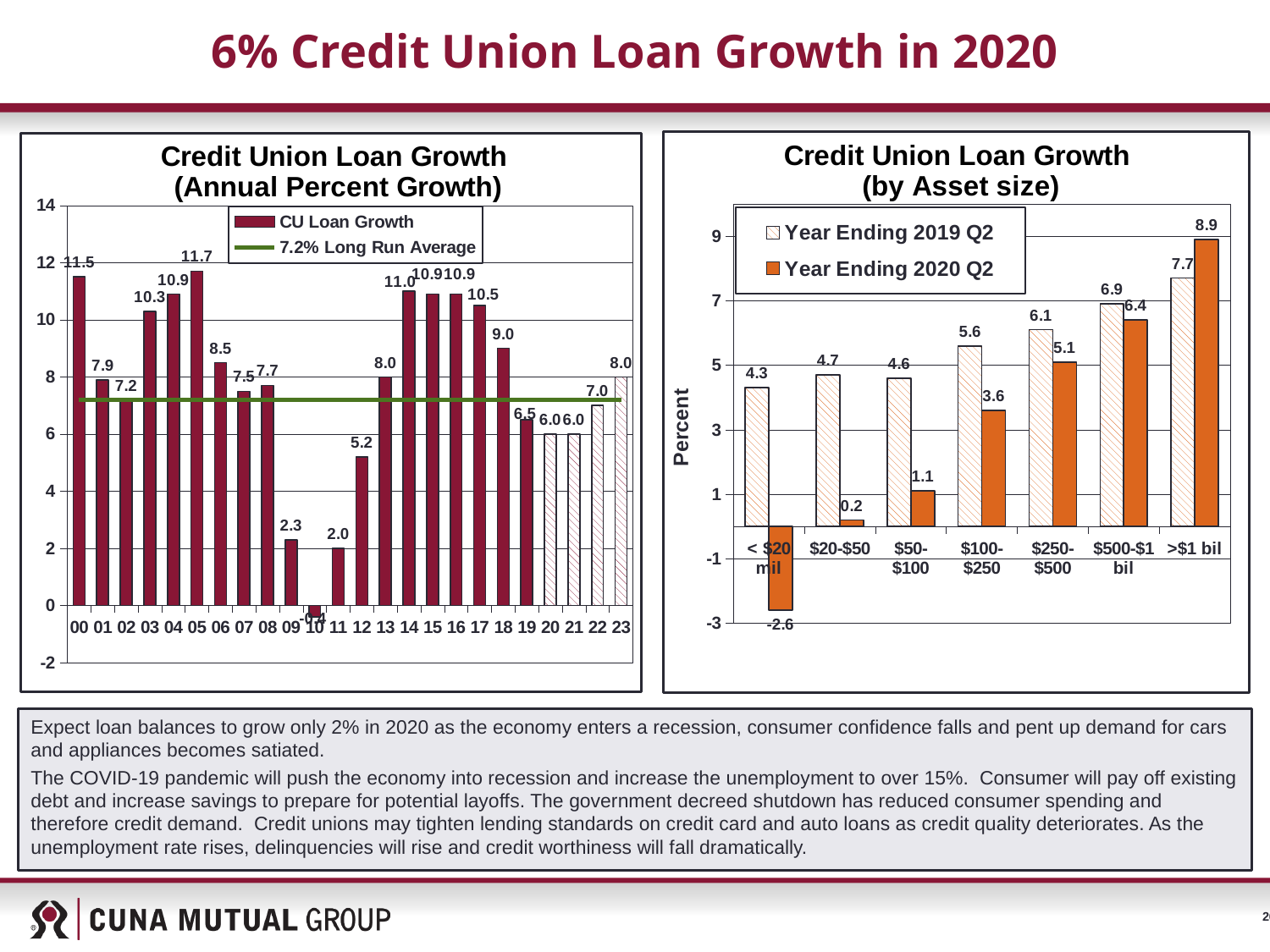
In the 'Credit Union Loan Growth (Annual Percent Growth)' chart, is the value for 2012 greater or less than the value for 2013? less In the 'Credit Union Loan Growth (by Asset size)' chart, how many series does the legend list? 2 In the 'Credit Union Loan Growth (by Asset size)' chart, what is the Year Ending 2020 Q2 value for credit unions with less than $20 mil in assets? -2.6 In the 'Credit Union Loan Growth (Annual Percent Growth)' chart, what is the loan growth value for 2005? 11.7 In the 'Credit Union Loan Growth (Annual Percent Growth)' chart, do the values rise or fall from 2009 to 2010? fall In the 'Credit Union Loan Growth (by Asset size)' chart, what is the difference between the Year Ending 2019 Q2 and Year Ending 2020 Q2 values for the $100-$250 category? 2.0 What kind of chart is 'Credit Union Loan Growth (by Asset size)'? bar chart In the 'Credit Union Loan Growth (Annual Percent Growth)' chart, which year has the lowest loan growth? 10 In the 'Credit Union Loan Growth (by Asset size)' chart, how many asset size categories are shown? 7 In the 'Credit Union Loan Growth (Annual Percent Growth)' chart, what is the difference between the values for 2018 and 2019? 2.5 In the 'Credit Union Loan Growth (by Asset size)' chart, which asset size category has the highest Year Ending 2020 Q2 value? >$1 bil In the 'Credit Union Loan Growth (Annual Percent Growth)' chart, what long run average does the legend give? 7.2%